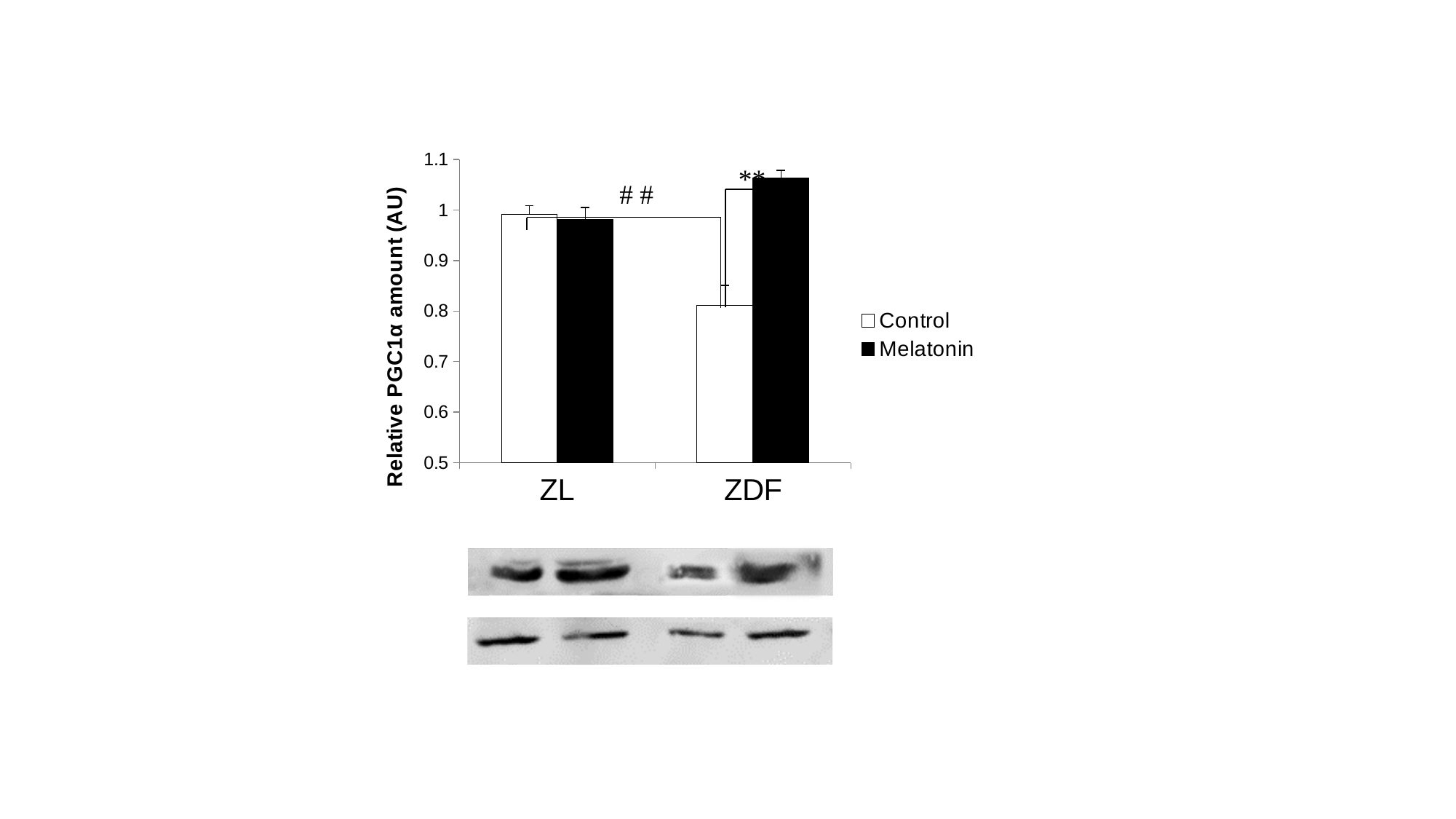
For ZDF, which is larger: the Control value or the Melatonin value? Melatonin How many series does the chart's legend list? 2 What kind of chart is shown on the slide? bar chart What is the label of the y axis of the chart? Relative PGC1α amount (AU) Is the Melatonin value for ZL greater or less than 0.8? greater How many categories are shown on the x axis of the chart? 2 Is the Melatonin value for ZDF greater or less than 1? greater Which bar has the highest value in the chart? ZDF Melatonin Which bar has the lowest value in the chart? ZDF Control Which series are listed in the chart's legend? Control and Melatonin Is the Control value for ZL greater or less than 0.9? greater